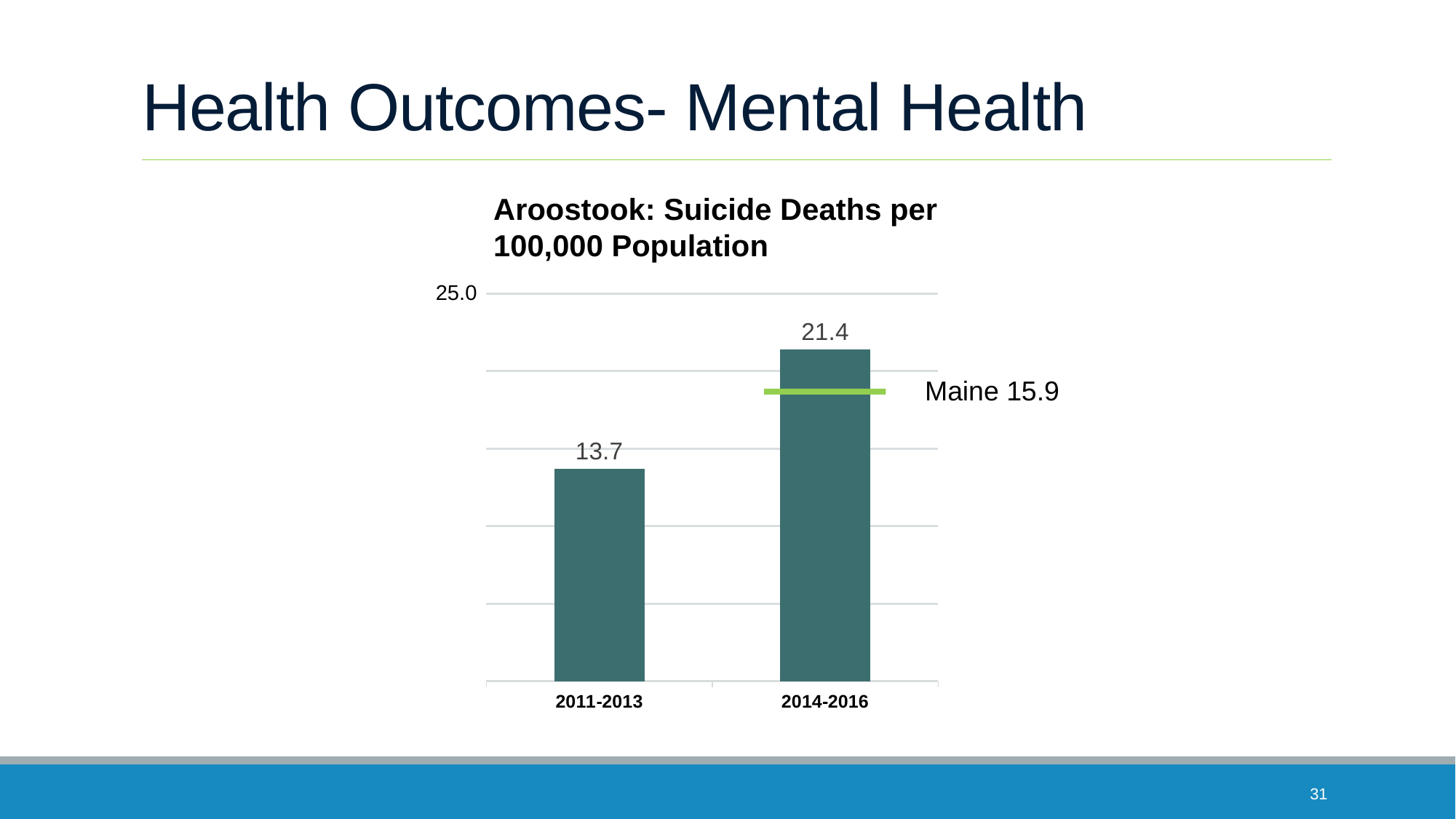
How many time periods are shown on the chart? 2 Is the Aroostook suicide death rate for 2014-2016 greater or less than the Maine rate of 15.9? greater What is the suicide death rate per 100,000 population for Aroostook in 2011-2013? 13.7 Which period has the lower suicide death rate for Aroostook? 2011-2013 What is the Maine suicide death rate shown as a reference line on the chart? 15.9 Which period has the higher suicide death rate for Aroostook? 2014-2016 What is the suicide death rate per 100,000 population for Aroostook in 2014-2016? 21.4 Does the Aroostook suicide death rate rise or fall from 2011-2013 to 2014-2016? Rise Is the Aroostook suicide death rate higher in 2011-2013 or 2014-2016? 2014-2016 What type of chart is used to show Aroostook suicide deaths? Bar chart By how much did the Aroostook suicide death rate increase from 2011-2013 to 2014-2016? 7.7 What is the title of the chart on the slide? Aroostook: Suicide Deaths per 100,000 Population